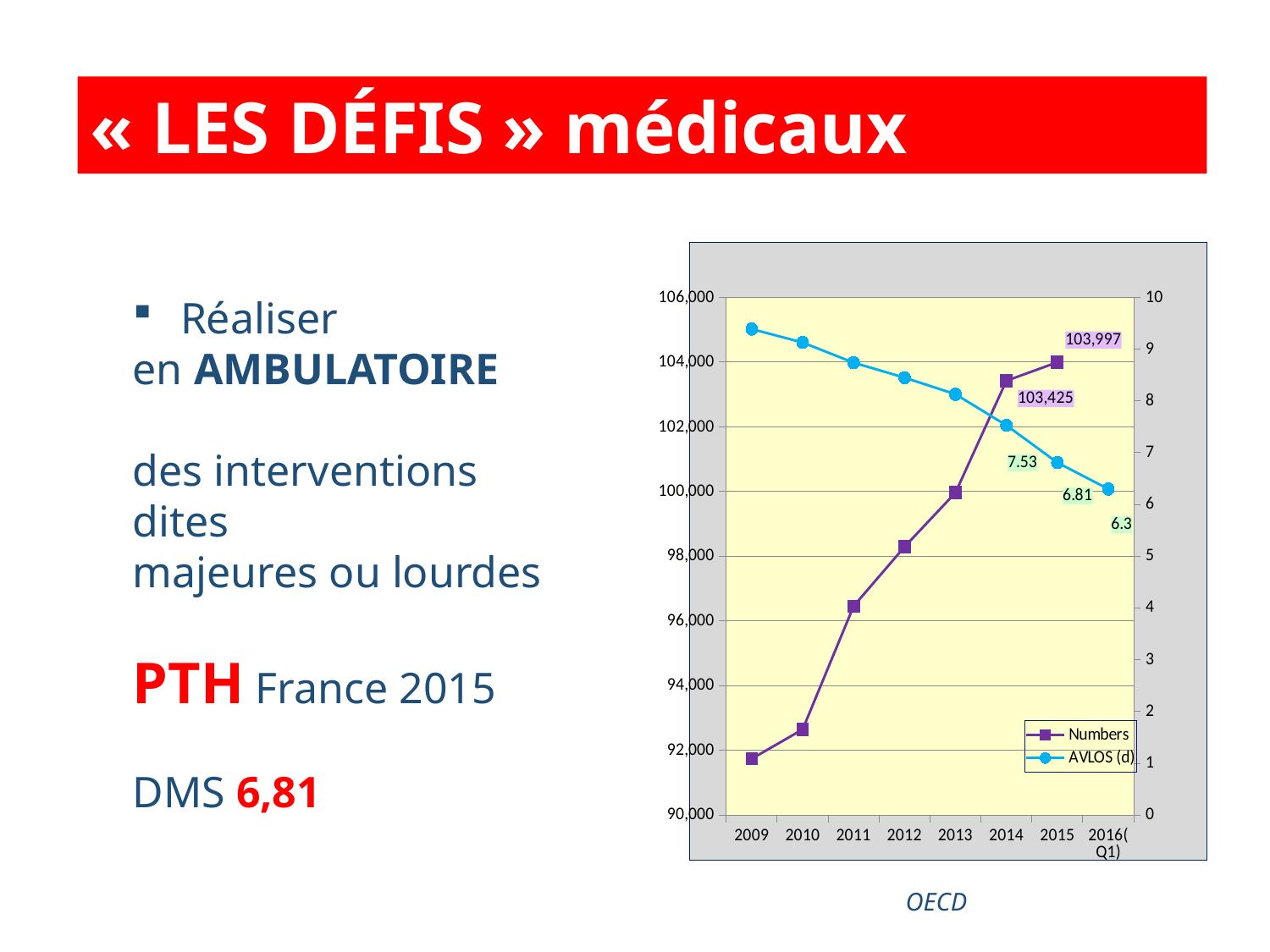
Is the value of the Numbers series in 2011 greater or less than 98,000? less What is the AVLOS (d) value in 2015? 6.81 How many series does the legend list? 2 Does the AVLOS (d) series rise or fall from 2009 to 2016(Q1)? Fall By how much did the Numbers series increase from 2014 to 2015? 572 How many categories are shown on the x axis? 8 What is the value of the Numbers series in 2015? 103,997 What is the AVLOS (d) value in 2014? 7.53 What is the difference between the AVLOS (d) values in 2014 and 2015? 0.72 What is the value of the Numbers series in 2014? 103,425 What is the AVLOS (d) value in 2016(Q1)? 6.3 What kind of chart is shown on the slide? Line chart